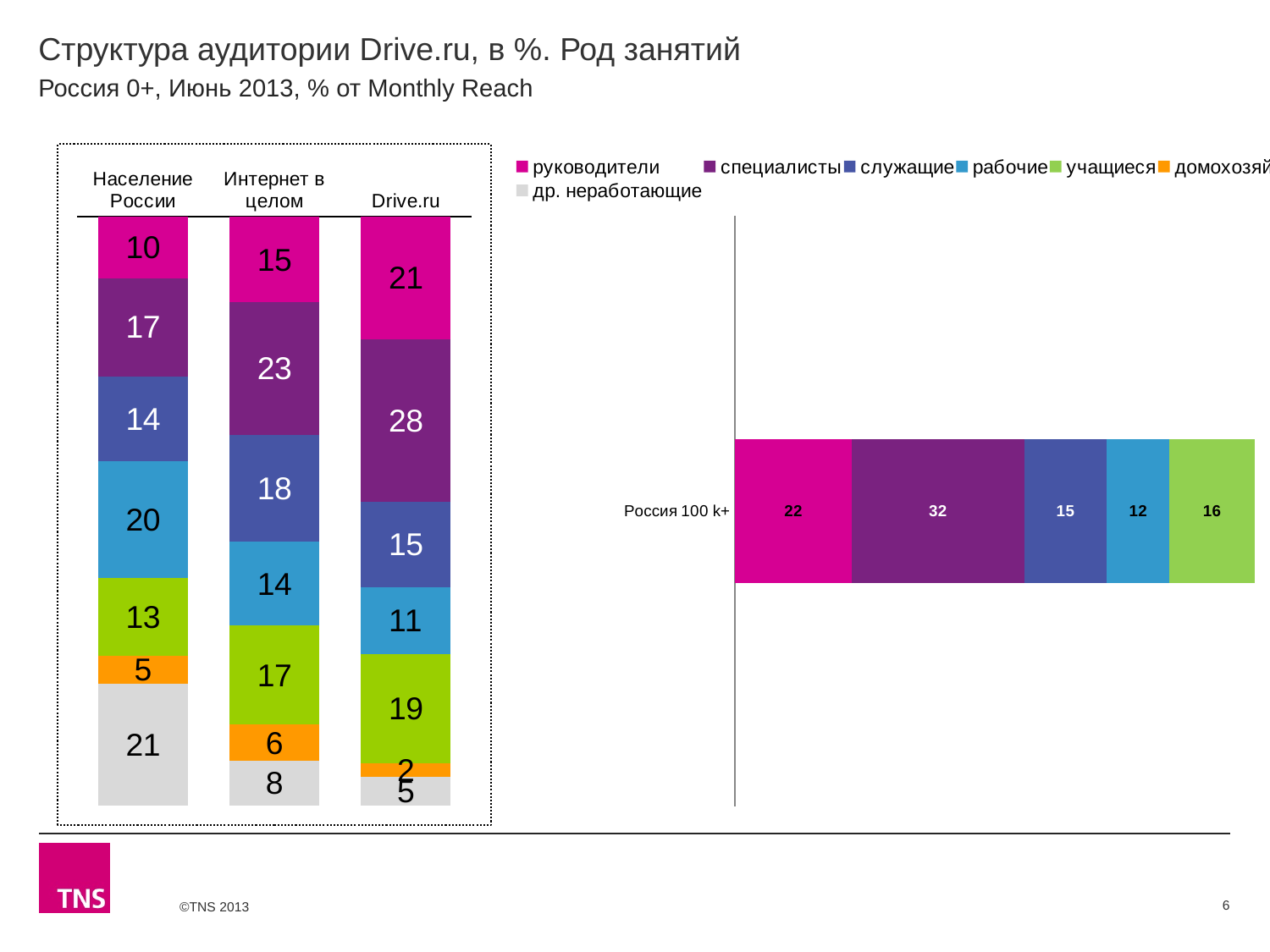
In the right chart (Россия 100 k+), which segment has the highest value? специалисты In the left stacked bar chart, what is the value for специалисты in the Drive.ru bar? 28 How many bars are shown in the left stacked bar chart? 3 What kind of chart is the left chart on the slide? Stacked bar chart In the left stacked bar chart, which bar has the larger учащиеся value: Drive.ru or Интернет в целом? Drive.ru In the right chart (Россия 100 k+), which segment has the lowest value? рабочие In the left stacked bar chart, what is the value for др. неработающие in the Население России bar? 21 How many series does the legend on the slide list? 7 In the right chart (Россия 100 k+), what is the value for специалисты? 32 In the left stacked bar chart, what is the value for учащиеся in the Интернет в целом bar? 17 In the right chart (Россия 100 k+), what is the total of all the labelled segments? 97 In the left stacked bar chart, how much larger is the руководители value for Drive.ru than for Население России? 11